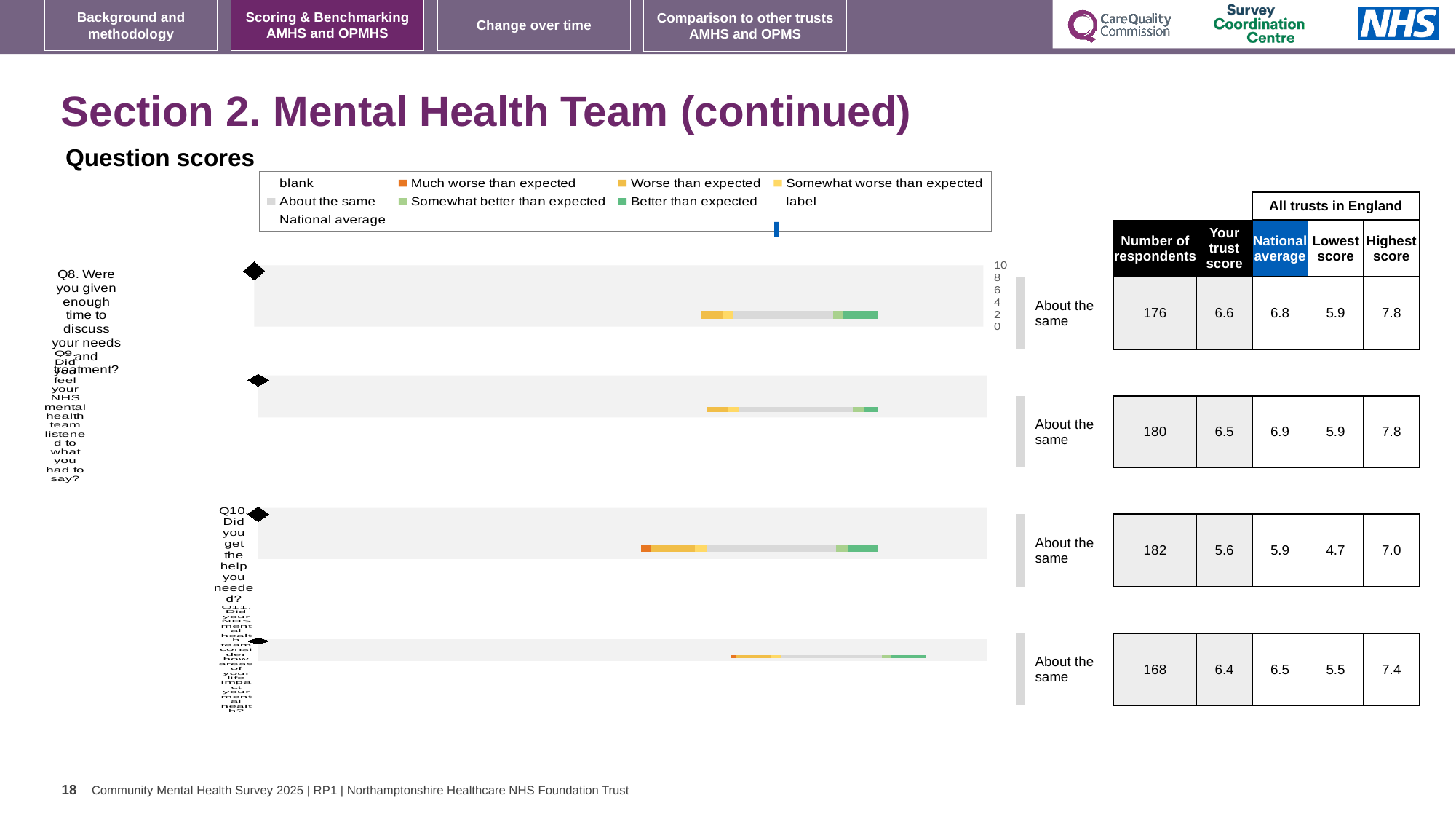
What kind of chart is used to show the question scores for Q8 to Q11? bar chart In the table beside the Q9 chart, what is the 'Your trust score' value? 6.5 In the table beside the Q11 chart, what is the highest score among all trusts in England? 7.4 How many question bar charts (Q8 to Q11) are shown on the slide? 4 Which question (Q8 to Q11) has the highest number of respondents in the table beside the charts? Q10 For Q8, what is the difference between the highest score (7.8) and the lowest score (5.9) in the table beside the chart? 1.9 In the legend above the charts, which colour represents 'Better than expected'? green In the table beside the Q10 chart, what is the national average? 5.9 In the table beside the Q8 chart, what is the number of respondents? 176 In the legend above the charts, which colour represents 'Much worse than expected'? orange Which question (Q8 to Q11) has the lowest 'Your trust score' in the table beside the charts? Q10 How many entries does the legend above the question score charts list? 9